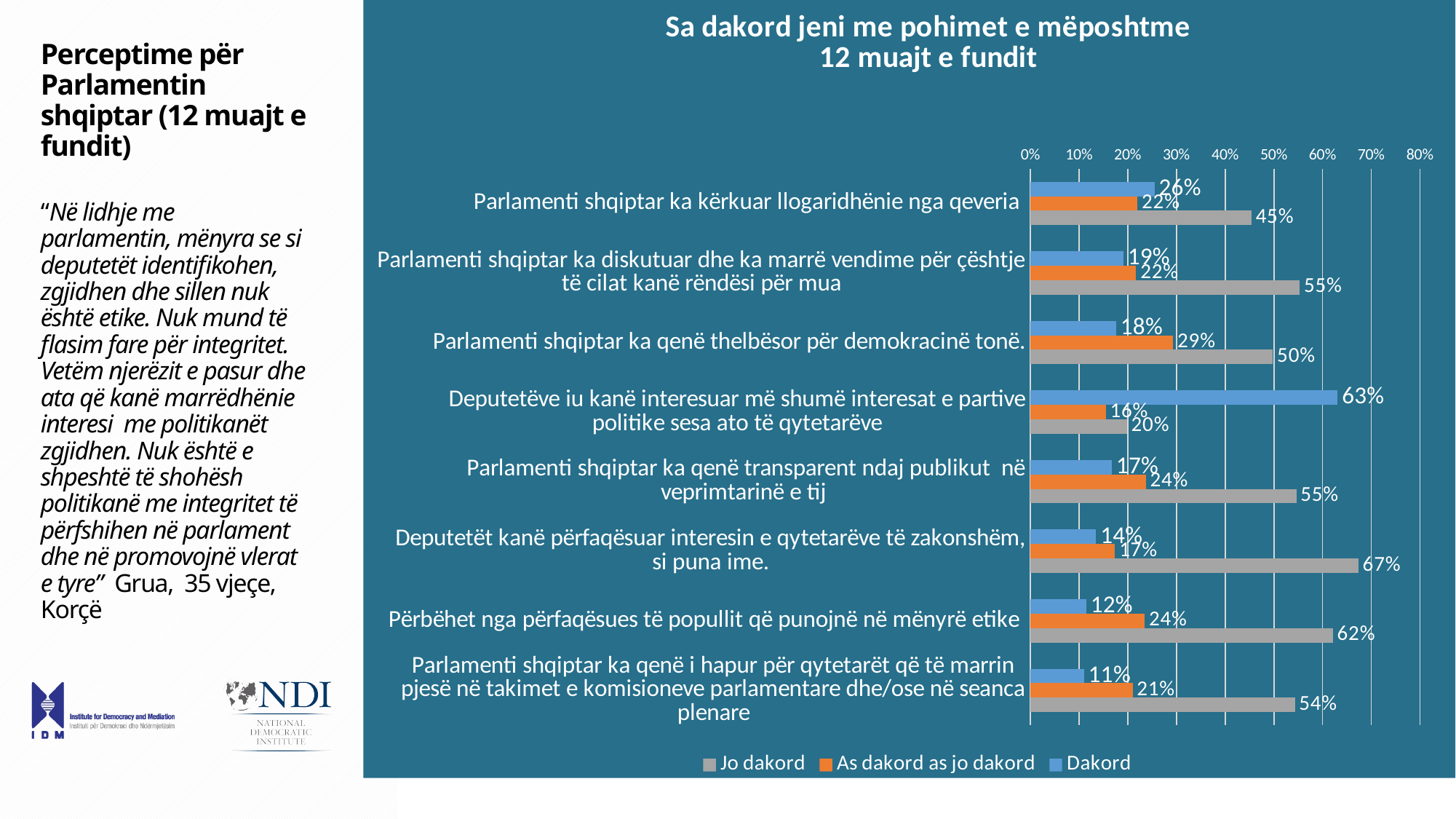
For "Përbëhet nga përfaqësues të popullit që punojnë në mënyrë etike", which is larger: "As dakord as jo dakord" or "Dakord"? As dakord as jo dakord Which colour represents the "Jo dakord" series? Gray What is the "Dakord" value for "Deputetëve iu kanë interesuar më shumë interesat e partive politike sesa ato të qytetarëve"? 63% What kind of chart is shown on the slide? Bar chart Which statement has the lowest "Dakord" value? Parlamenti shqiptar ka qenë i hapur për qytetarët që të marrin pjesë në takimet e komisioneve parlamentare dhe/ose në seanca plenare How many series does the legend list? 3 How many statements (categories) are shown in the chart? 8 What is the "As dakord as jo dakord" value for "Parlamenti shqiptar ka qenë thelbësor për demokracinë tonë."? 29% What is the title of the chart? Sa dakord jeni me pohimet e mëposhtme 12 muajt e fundit What is the difference between the "Jo dakord" and "Dakord" values for "Parlamenti shqiptar ka kërkuar llogaridhënie nga qeveria"? 19% Which statement has the highest "Dakord" value? Deputetëve iu kanë interesuar më shumë interesat e partive politike sesa ato të qytetarëve What is the "Jo dakord" value for "Deputetët kanë përfaqësuar interesin e qytetarëve të zakonshëm, si puna ime."? 67%